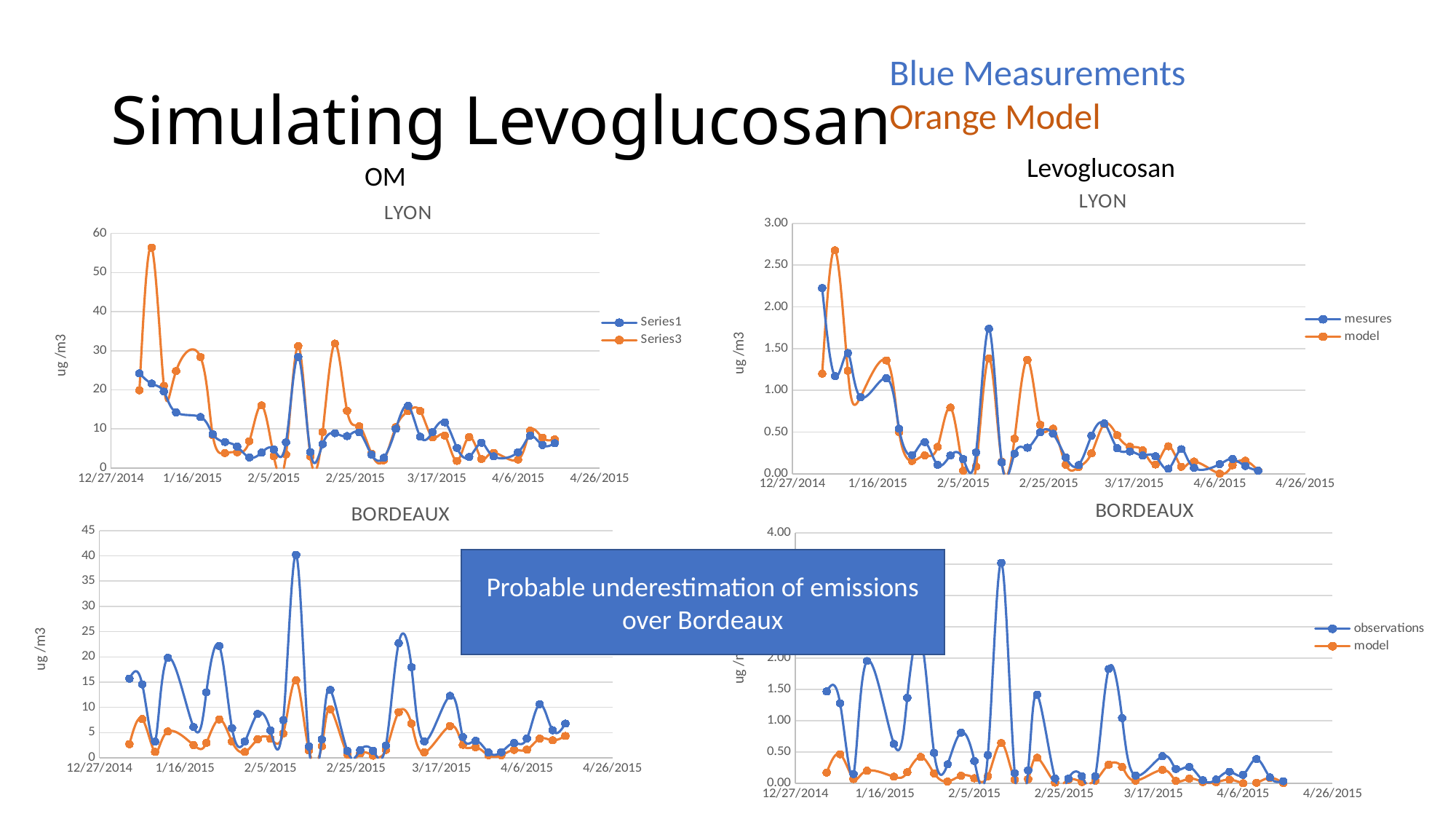
How many series does the legend of the bottom-right BORDEAUX chart (Levoglucosan) list? 2 How many series does the legend of the top-left LYON chart (OM) list? 2 In the bottom-right BORDEAUX chart (Levoglucosan), which series reaches the higher peak value, observations or model? observations What is the y-axis label of the top-left LYON chart (OM)? ug /m3 In the top-left LYON chart (OM), is the highest value of Series3 greater or less than 50? greater What are the two legend entries of the top-right LYON chart (Levoglucosan)? mesures and model In the bottom-right BORDEAUX chart (Levoglucosan), is the highest value of the observations series greater or less than 3.00? greater In the top-right LYON chart (Levoglucosan), do the mesures values generally rise or fall from 12/27/2014 to 4/26/2015? fall What kind of chart is the top-left chart titled LYON (under OM)? line chart In the top-right LYON chart (Levoglucosan), is the highest value of the model series greater or less than 2.50? greater